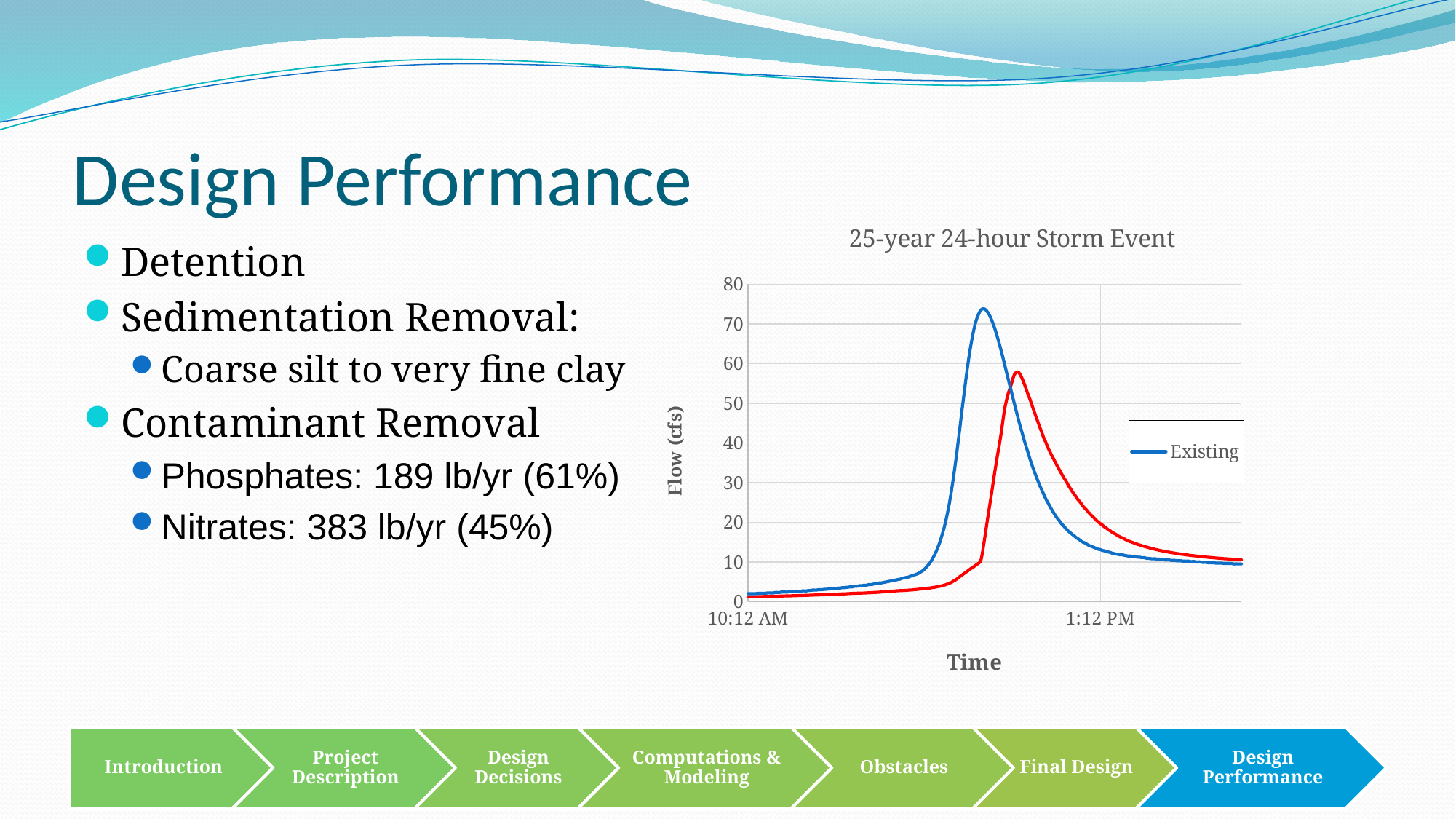
Which line reaches a higher peak flow, the blue Existing line or the red line? the blue Existing line What is the highest value shown on the vertical axis of the chart? 80 What is the label on the chart's vertical axis? Flow (cfs) How many series does the chart's legend list? 1 Is the peak value of the red line greater or less than 50? greater Is the peak value of the Existing series greater or less than 70? greater Is the value of the Existing series at 10:12 AM greater or less than 10? less What is the title of the chart? 25-year 24-hour Storm Event What kind of chart is shown on the slide? line chart Which line reaches its peak earlier in time, the blue Existing line or the red line? the blue Existing line